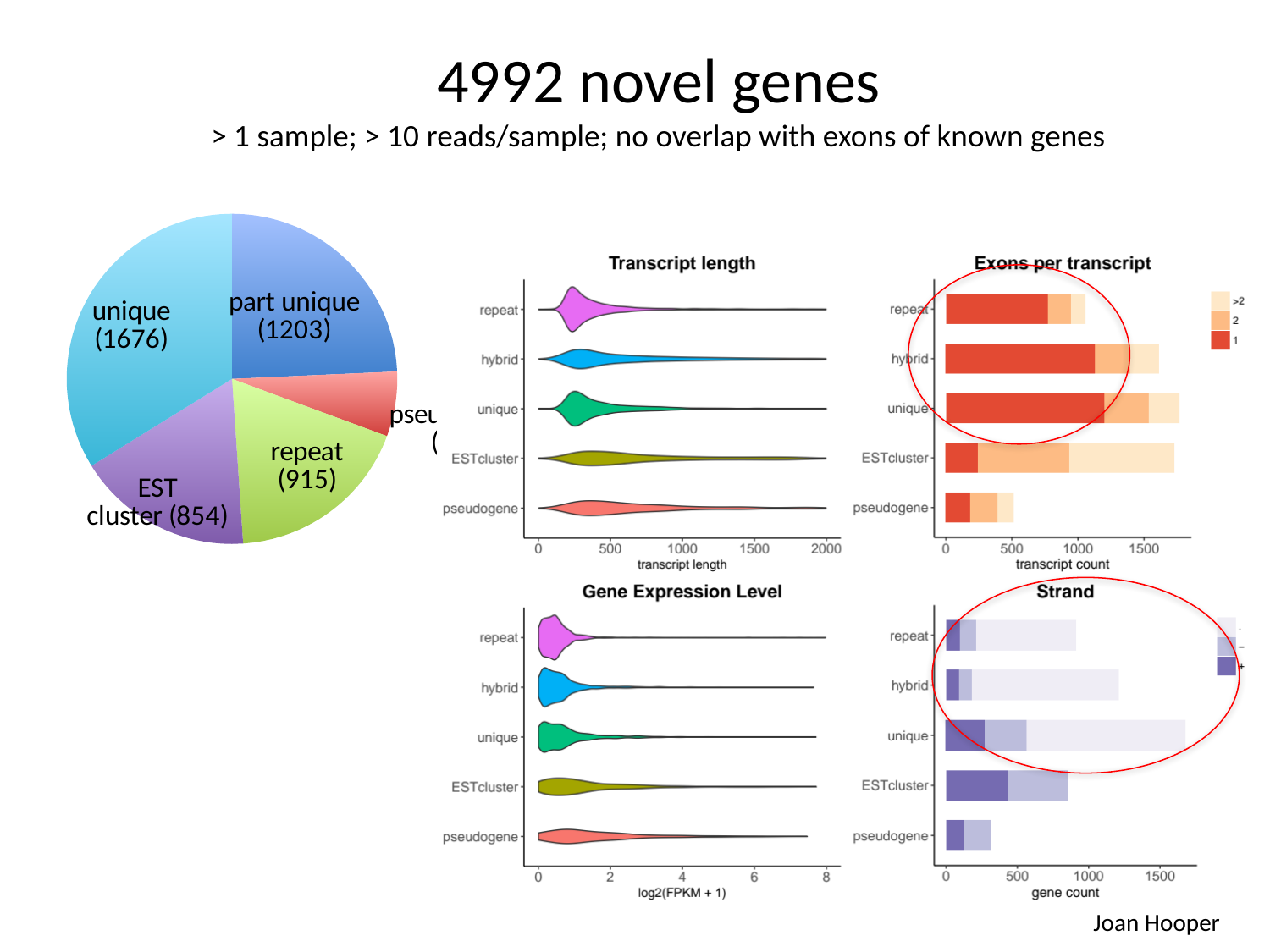
In the pie chart, what is the value shown for 'part unique'? 1203 In the 'Strand' chart, is the total gene count for 'unique' greater or less than 1500? greater In the 'Exons per transcript' chart, which category has the shortest total bar? pseudogene In the pie chart, what is the value shown for 'EST cluster'? 854 In the pie chart, which is larger: 'repeat' or 'EST cluster'? repeat In the pie chart, how many novel genes are in the 'unique' category? 1676 In the pie chart, which category has the largest slice? unique In the 'Exons per transcript' chart, how many categories are shown on the y axis? 5 In the 'Exons per transcript' chart, how many series does the legend list? 3 What kind of chart is the chart on the left of the slide? pie chart In the pie chart, what is the difference between the 'unique' and 'part unique' values? 473 In the pie chart, how many novel genes are in the 'repeat' category? 915